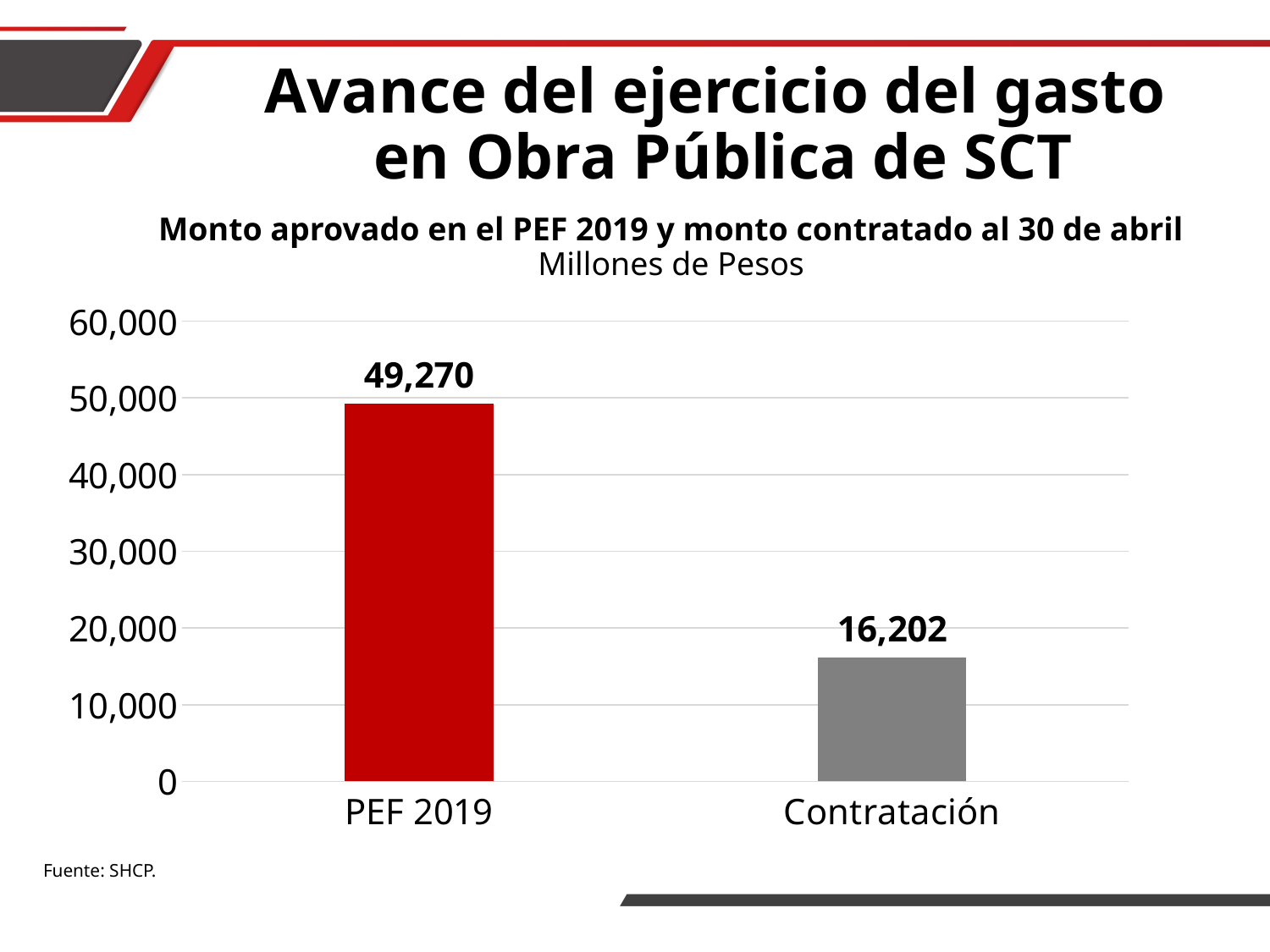
What kind of chart is shown on the slide? Bar chart What is the value for Contratación? 16,202 What is the difference between the PEF 2019 value and the Contratación value? 33,068 How many categories are shown on the x axis? 2 Is the value for Contratación greater or less than 20,000? less What colour is the bar for PEF 2019? Red Which is larger, the value for PEF 2019 or the value for Contratación? PEF 2019 What unit is stated in the chart subtitle? Millones de Pesos What is the value for PEF 2019? 49,270 Is the value for PEF 2019 greater or less than 40,000? greater Which category has the lowest value? Contratación Which category has the highest value? PEF 2019